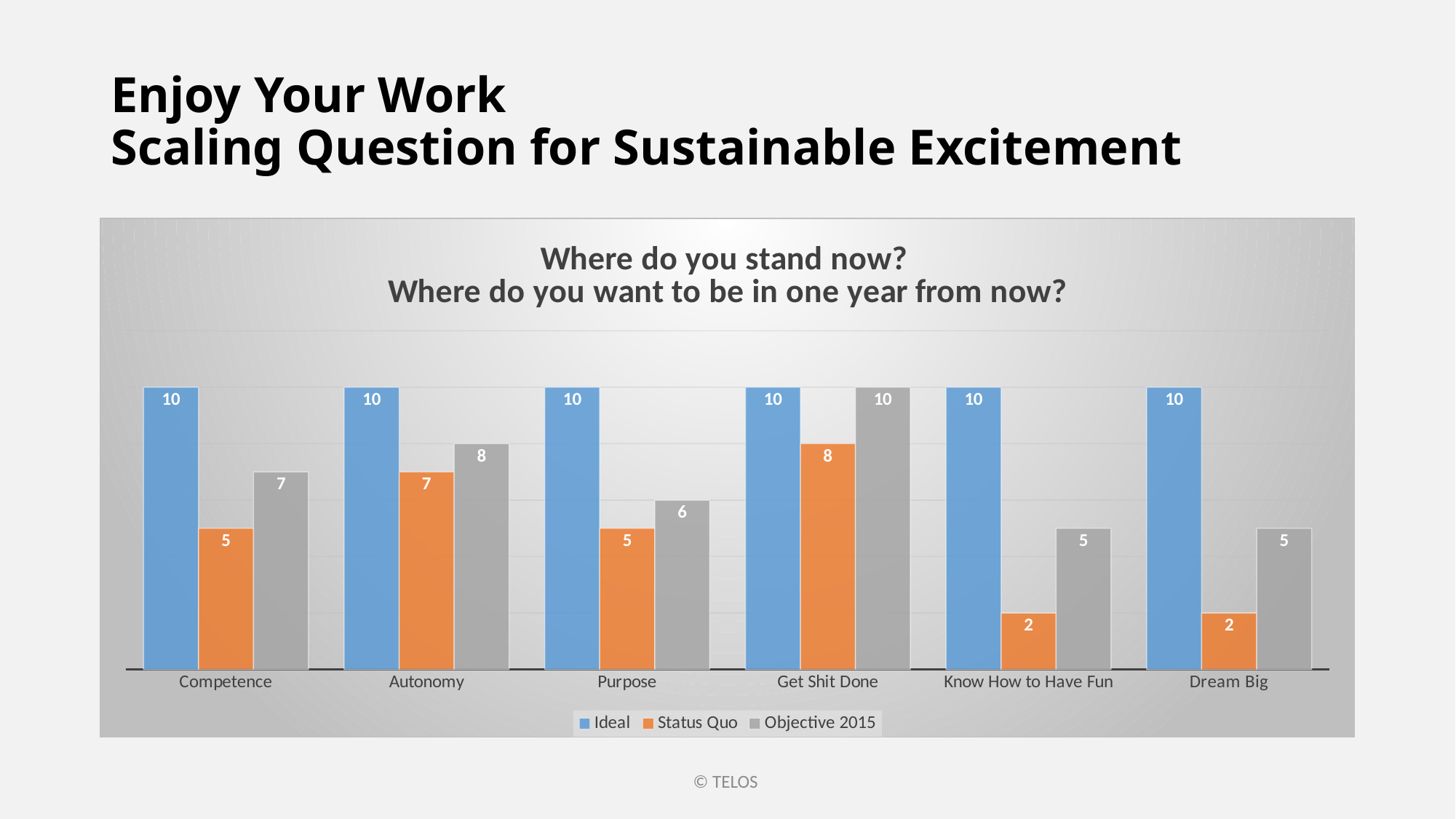
What is the Objective 2015 value for Purpose? 6 How many categories are shown on the x axis? 6 What is the difference between the Ideal and Status Quo values for Competence? 5 What is the Status Quo value for Dream Big? 2 What is the Status Quo value for Autonomy? 7 Which category has the lowest Objective 2015 value? Know How to Have Fun and Dream Big Which is larger, the Status Quo value for Autonomy or the Status Quo value for Purpose? Autonomy Which category has the highest Status Quo value? Get Shit Done What is the difference between the Objective 2015 and Status Quo values for Know How to Have Fun? 3 What kind of chart is shown on the slide? Bar chart How many series does the legend list? 3 Which series is shown in orange? Status Quo